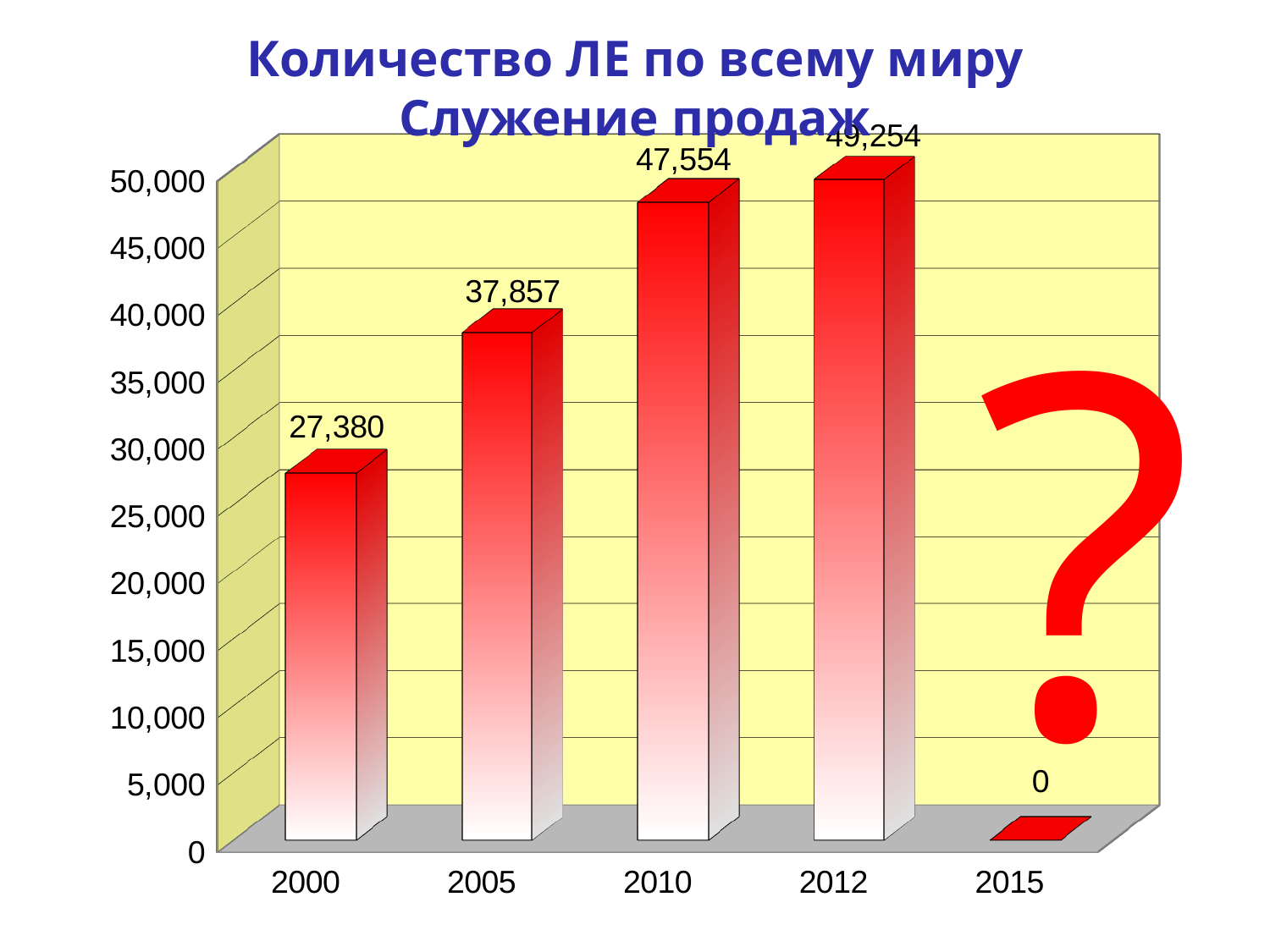
What is the value for 2005? 37,857 What is the value for 2000? 27,380 What is the value shown for 2015? 0 Which is larger, the value for 2005 or the value for 2010? 2010 What kind of chart is this? Bar chart Which year with a non-zero value has the lowest value? 2000 How many years are shown on the x axis? 5 What is the difference between the values for 2005 and 2000? 10,477 What is the value for 2012? 49,254 Which year has the highest value? 2012 What is the difference between the values for 2012 and 2010? 1,700 What is the value for 2010? 47,554